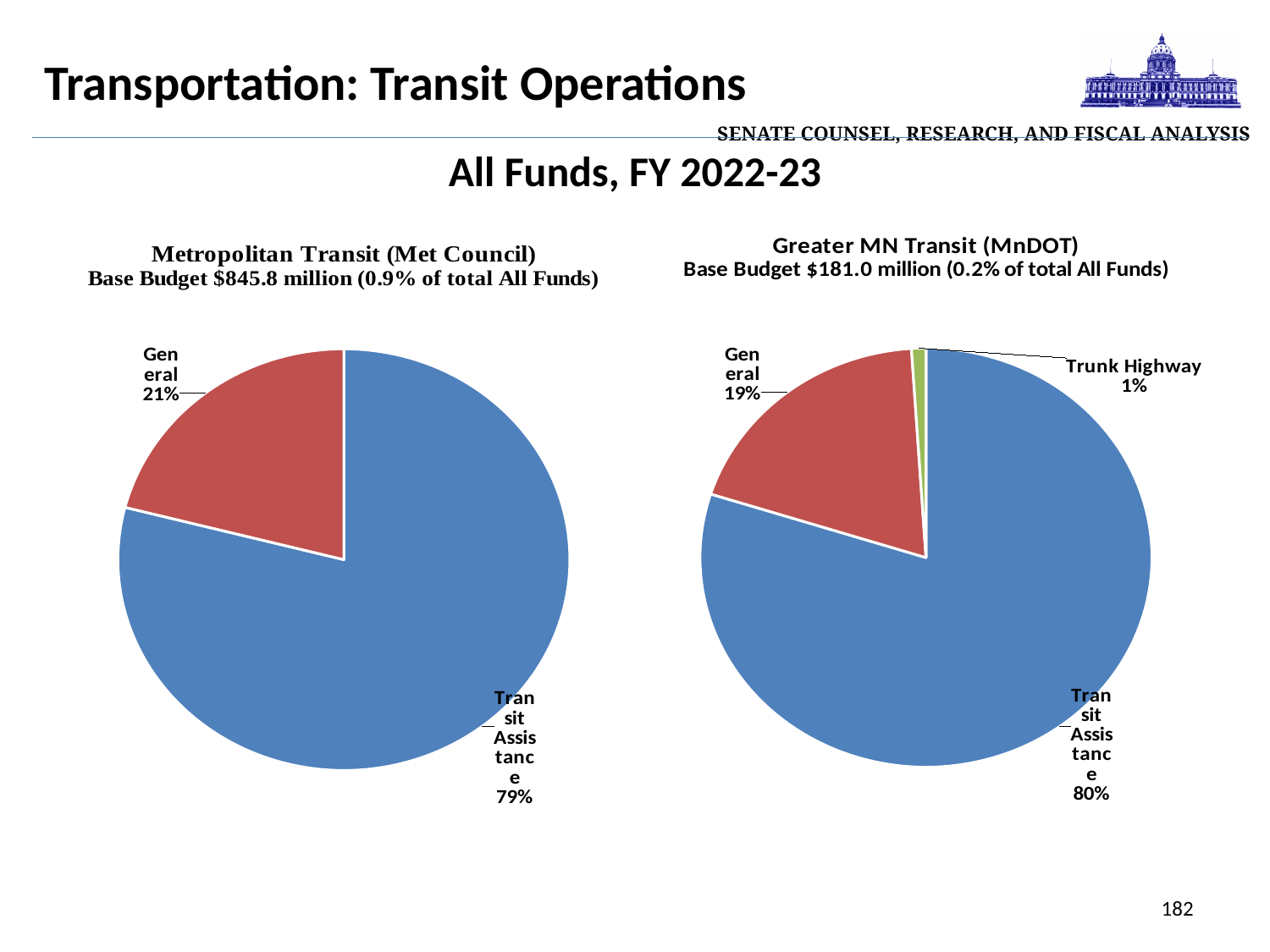
In the Greater MN Transit (MnDOT) pie chart, what share does General have? 19% How many slices does the Greater MN Transit (MnDOT) pie chart have? 3 What type of chart is used for Greater MN Transit (MnDOT)? Pie chart In the Greater MN Transit (MnDOT) pie chart, what share does Transit Assistance have? 80% In the Metropolitan Transit (Met Council) pie chart, what share does General have? 21% What base budget is stated in the title of the Greater MN Transit (MnDOT) chart? $181.0 million In the Metropolitan Transit (Met Council) pie chart, which slice is the largest? Transit Assistance In the Metropolitan Transit (Met Council) pie chart, what is the difference in percentage points between Transit Assistance and General? 58 How many slices does the Metropolitan Transit (Met Council) pie chart have? 2 In the Greater MN Transit (MnDOT) pie chart, which slice is the smallest? Trunk Highway